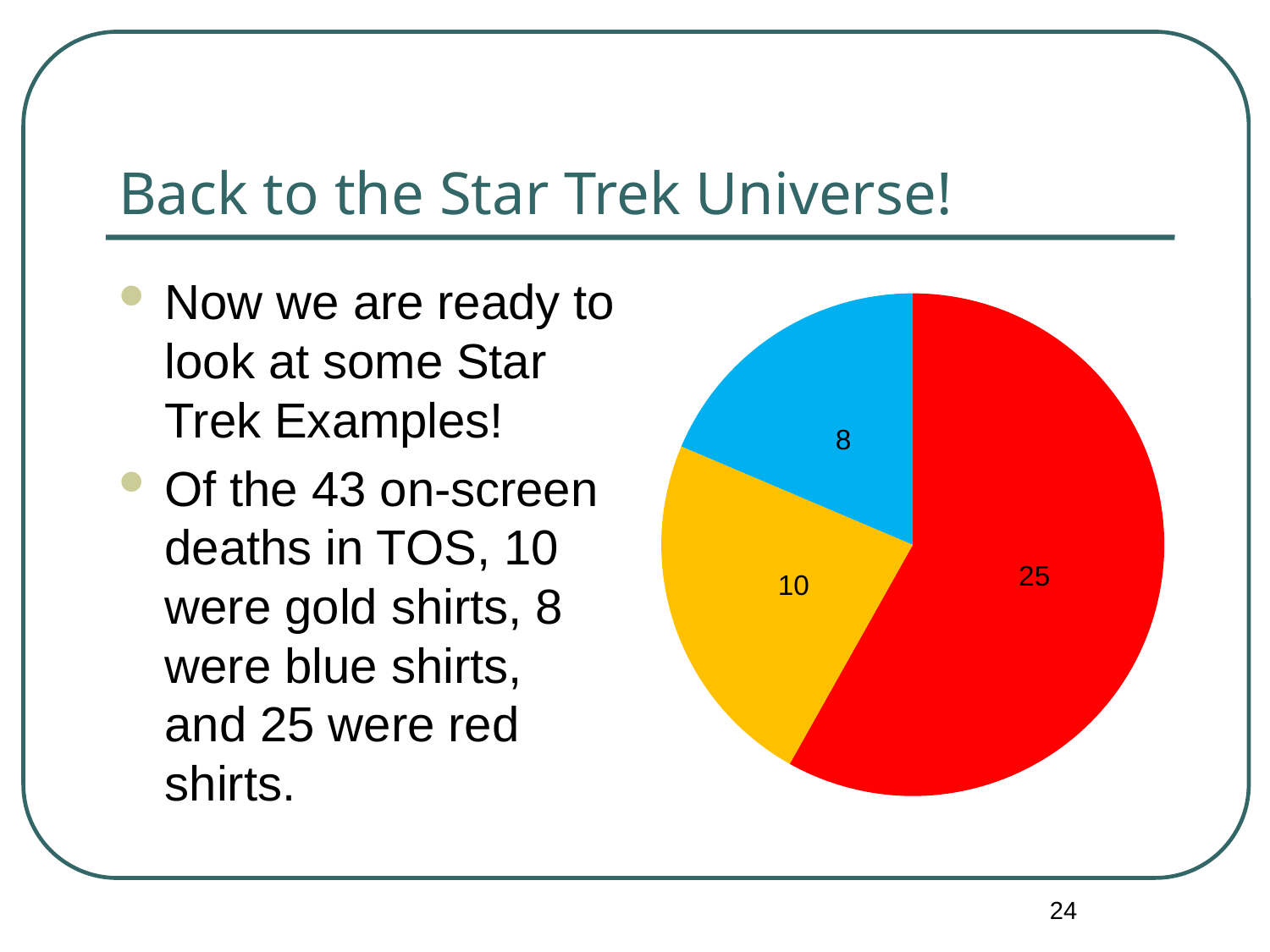
Which slice of the pie chart has the smallest value? blue (8) What kind of chart is shown on the slide? pie chart What is the total of all the slice values in the pie chart? 43 Which slice of the pie chart has the largest value? red (25) How many slices does the pie chart have? 3 What value is labelled on the blue slice of the pie chart? 8 What is the difference between the red slice value and the gold slice value? 15 Which is larger, the gold slice or the blue slice? gold What value is labelled on the gold (yellow) slice of the pie chart? 10 What colour is the slice labelled 8 in the pie chart? blue To the nearest whole percent, what share of the pie does the red slice represent? 58% What value is labelled on the red slice of the pie chart? 25